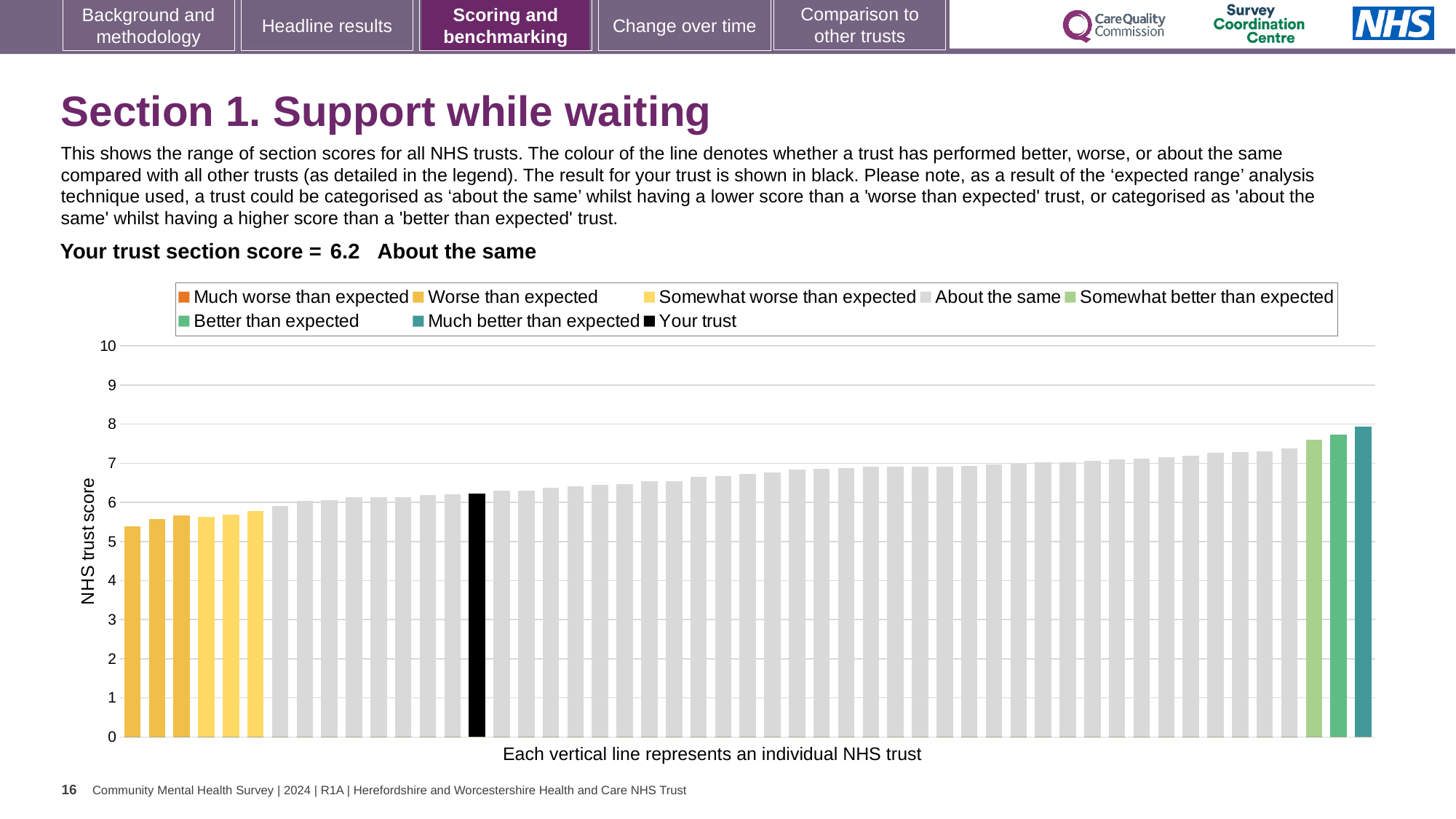
What is the label on the vertical axis of the chart? NHS trust score Is the value of the shortest bar greater or less than 5? greater Which legend category does the tallest bar belong to? Much better than expected Is the value of the tallest bar greater or less than 7? greater What kind of chart is shown on the slide? bar chart Is the value of the black 'Your trust' bar greater or less than 7? less Which category is your trust placed in for this section? About the same Do the bar values rise or fall from left to right along the x axis? rise What colour is the bar representing your trust? black How many entries does the chart legend list? 8 What is the section score for your trust shown on the slide? 6.2